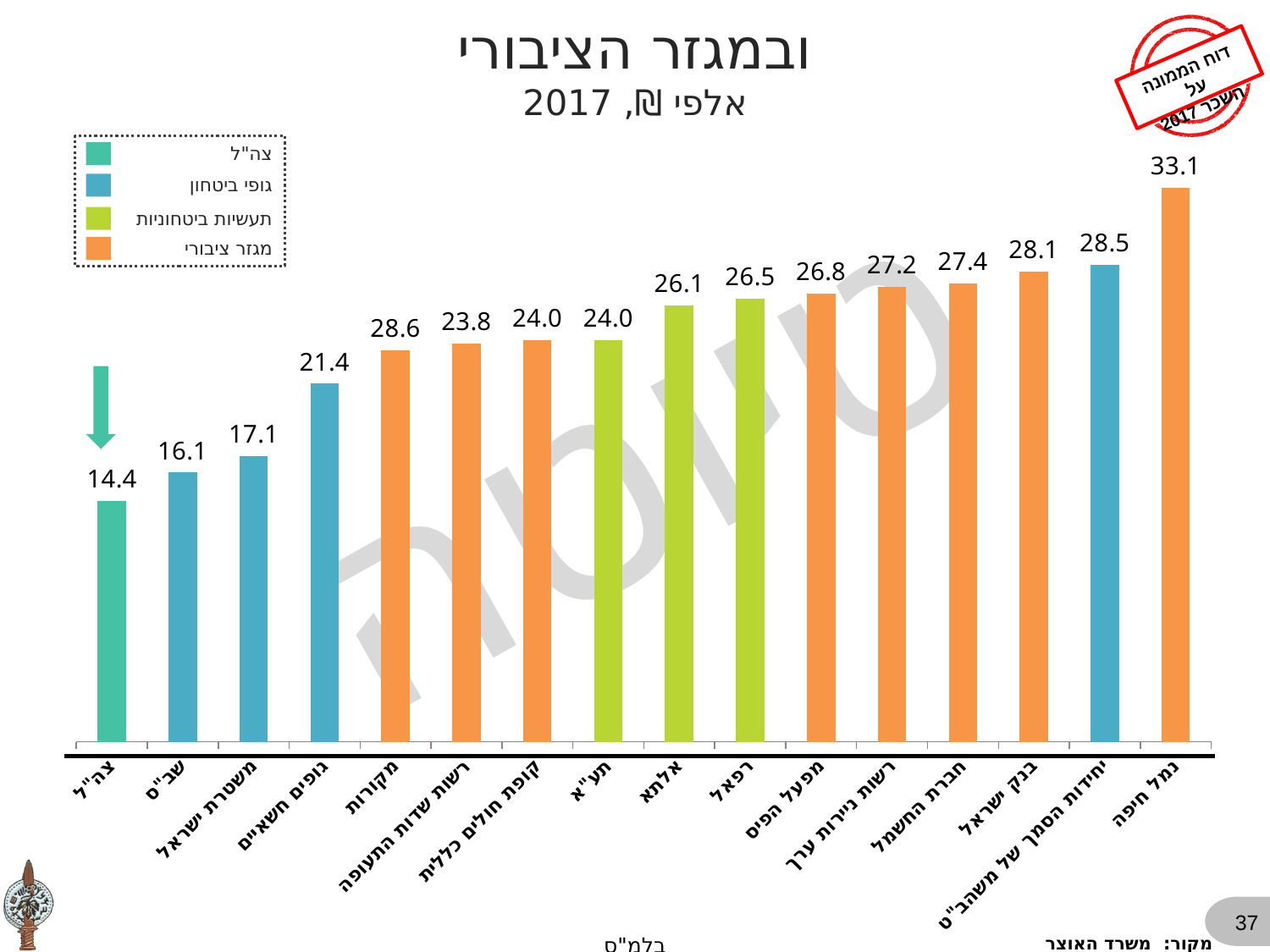
What type of chart is shown on the slide? bar chart How many categories are shown on the x axis? 16 How many entries does the legend list? 4 What is the value for נמל חיפה? 33.1 What is the value for צה"ל? 14.4 What is the value for רפאל? 26.5 What is the difference between the values for נמל חיפה and צה"ל? 18.7 Which is larger, the value for חברת החשמל or the value for משטרת ישראל? חברת החשמל What year is shown in the chart subtitle? 2017 Which category has the highest value? נמל חיפה What is the value for בנק ישראל? 28.1 Which category has the lowest value? צה"ל